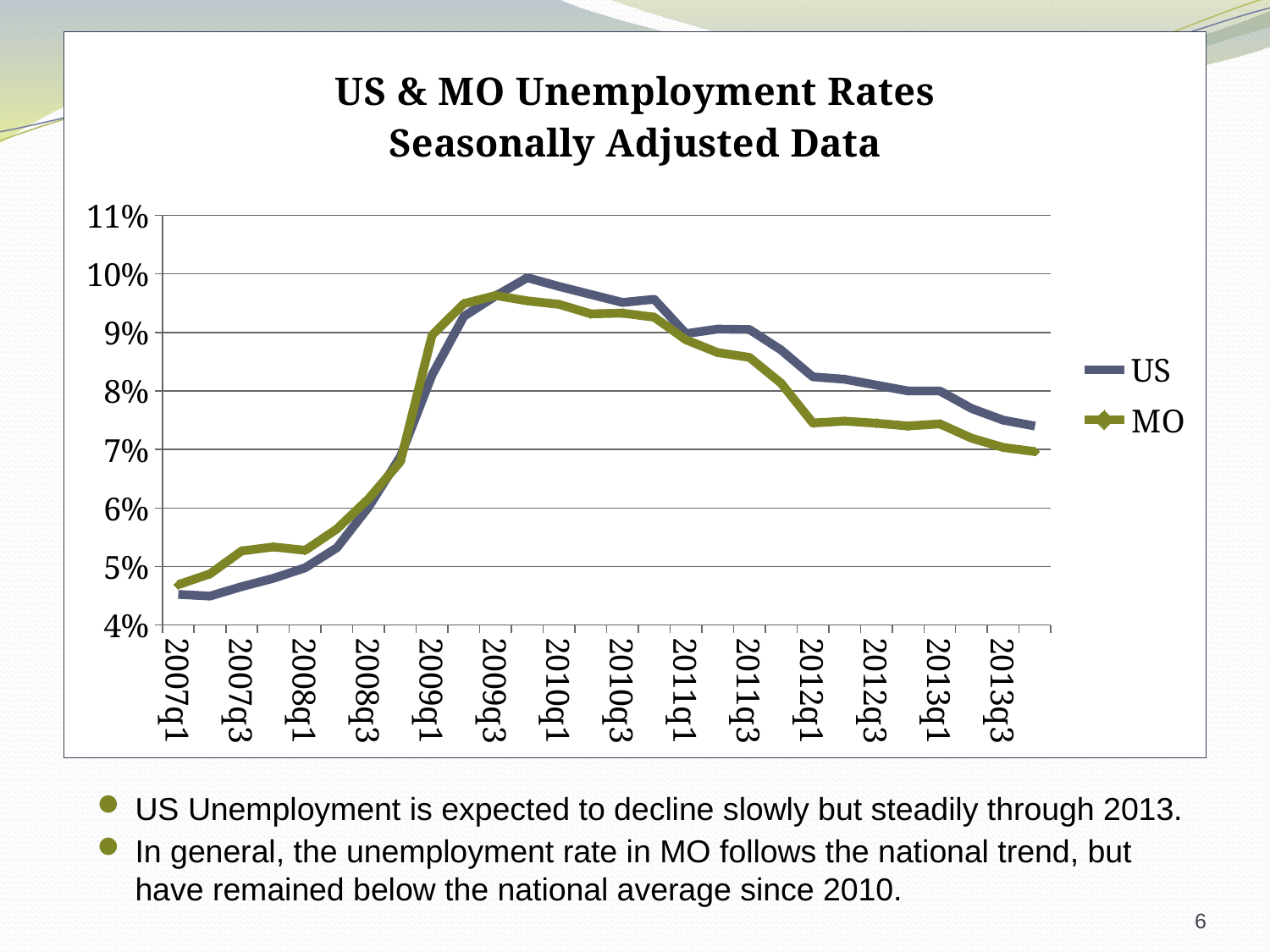
Is the MO unemployment rate at 2007q1 greater or less than 5%? less What are the two series named in the legend? US and MO How many series does the legend list? 2 From 2010q1 to 2013q3, does the US unemployment rate rise or fall? fall Is the US unemployment rate at 2012q1 greater or less than 9%? less At 2008q1, which series has the higher unemployment rate, US or MO? MO What kind of chart is shown on the slide? line chart At 2013q3, which series has the higher unemployment rate, US or MO? US Is the MO unemployment rate at 2013q3 greater or less than 8%? less Which series reaches the highest peak value on the chart? US What is the title of the chart? US & MO Unemployment Rates Seasonally Adjusted Data